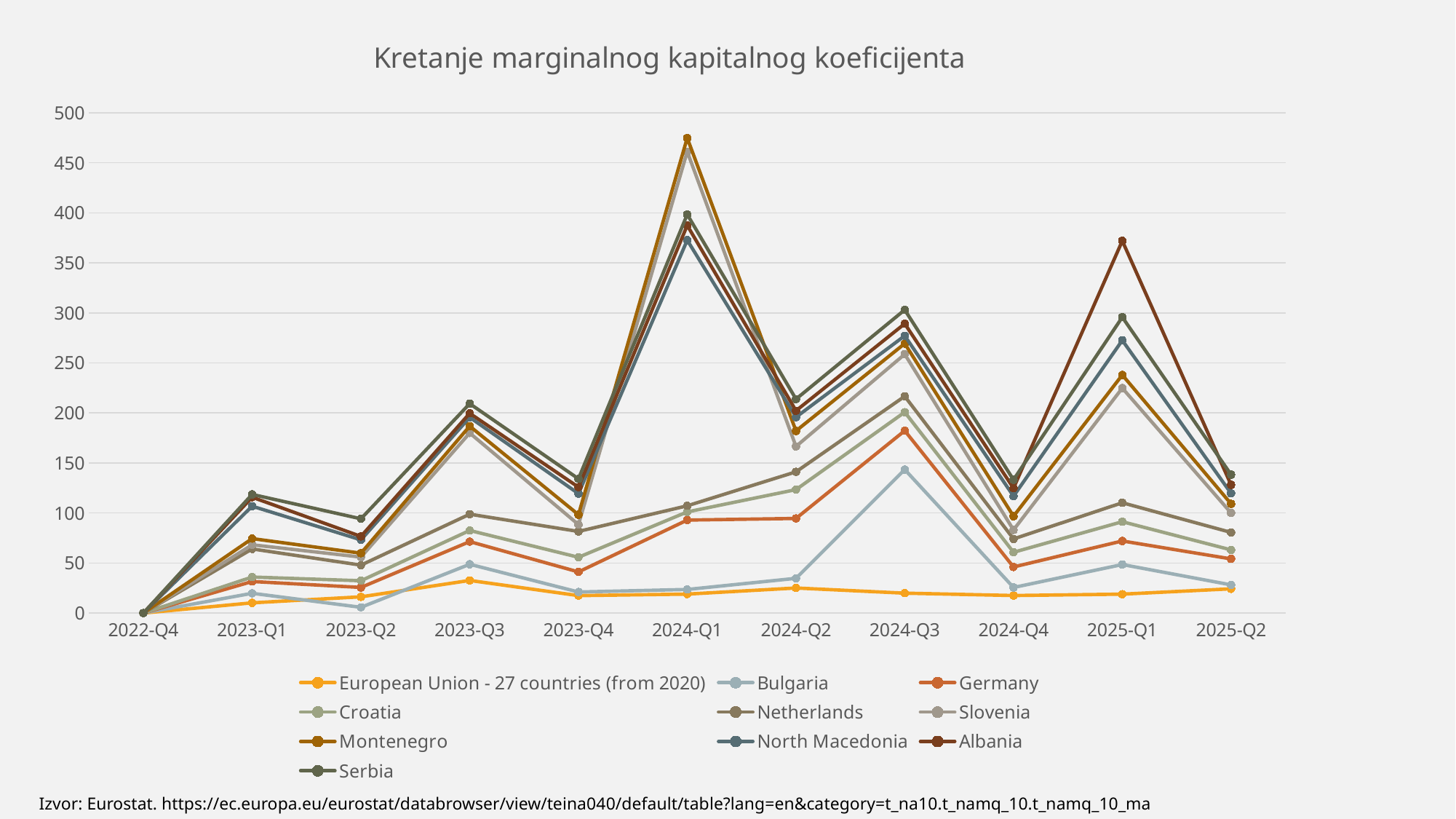
Does the value for Albania rise or fall from 2025-Q1 to 2025-Q2? fall What kind of chart is shown on the slide? line chart Which series has the highest value at 2025-Q1? Albania At 2024-Q3, which is larger: the value for Bulgaria or the value for Germany? Germany How many series does the legend list? 10 Is the value for Montenegro at 2024-Q1 greater or less than 450? greater What is the title of the chart? Kretanje marginalnog kapitalnog koeficijenta Is the value for Albania at 2025-Q1 greater or less than 350? greater Which series has the lowest value at 2024-Q3? European Union - 27 countries (from 2020) What is the value for European Union - 27 countries (from 2020) at 2022-Q4? 0 How many quarters are shown along the x axis? 11 Is the value for European Union - 27 countries (from 2020) at 2024-Q1 greater or less than 50? less